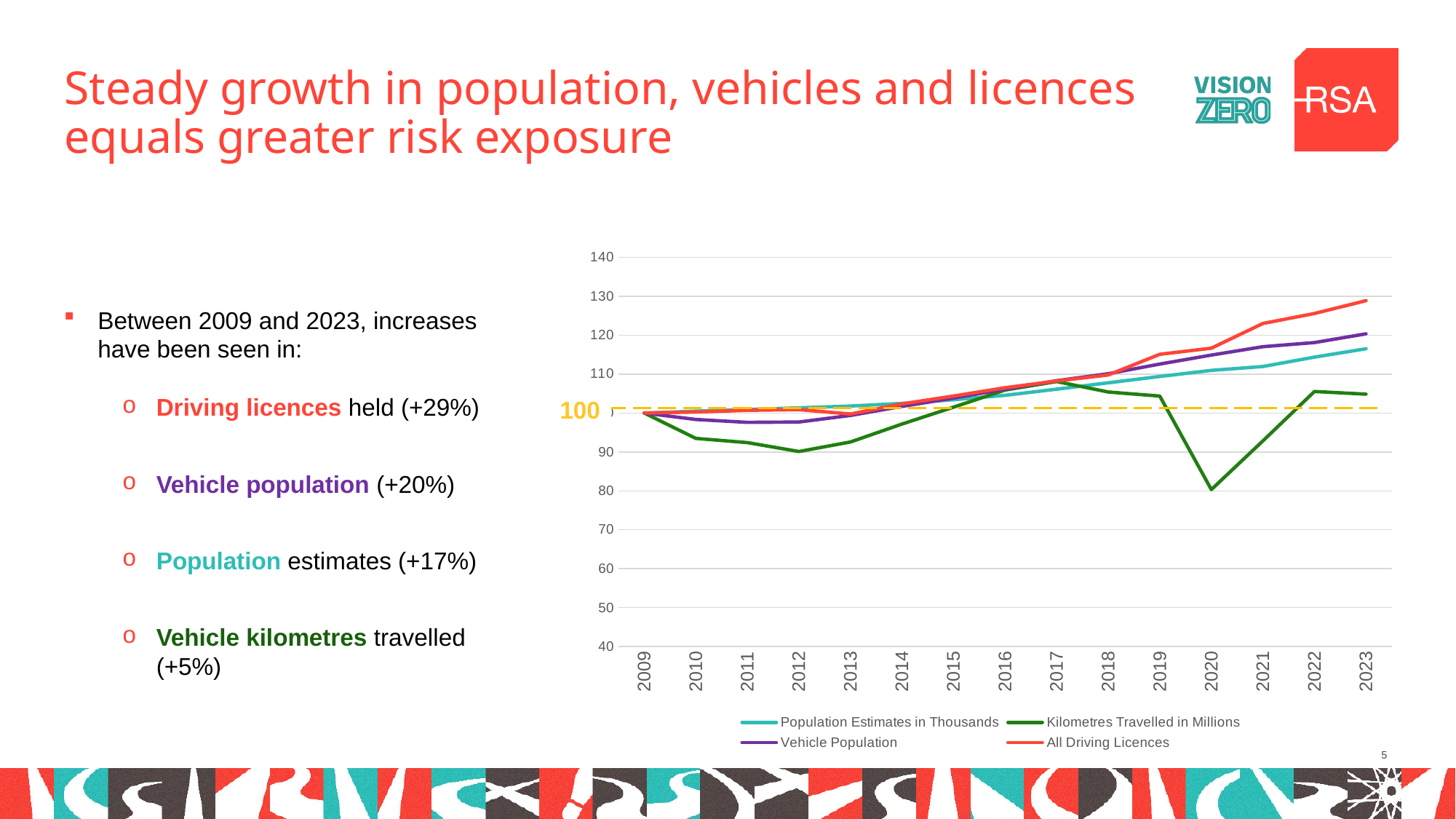
Does the All Driving Licences line rise or fall between 2013 and 2023? rise Which series has the lowest value in 2020? Kilometres Travelled in Millions Is the value for Vehicle Population in 2023 greater or less than 110? greater Is the value for Kilometres Travelled in Millions in 2012 greater or less than 100? less How many years are shown along the x axis of the chart? 15 Is the value for All Driving Licences in 2023 greater or less than 120? greater What value does the dashed horizontal reference line on the chart mark? 100 How many series does the chart's legend list? 4 In 2023, which is larger: All Driving Licences or Kilometres Travelled in Millions? All Driving Licences Which series has the highest value in 2023? All Driving Licences What kind of chart is shown on the slide? line chart